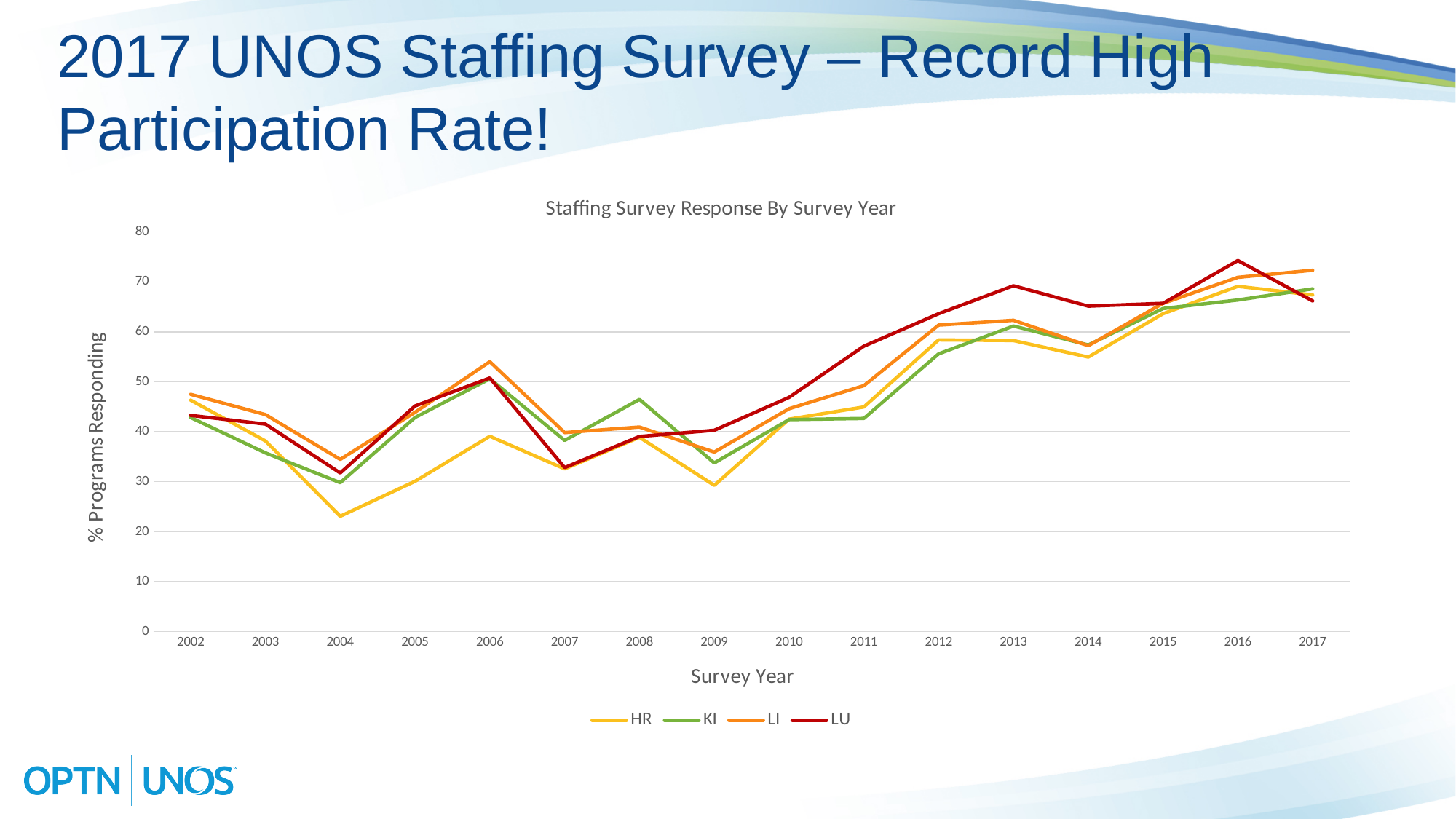
Which is larger for HR: the value in 2002 or the value in 2004? 2002 What is the label of the y axis? % Programs Responding Is the value for LI in 2006 greater or less than 50? greater What kind of chart is shown on the slide? Line chart Is the value for HR in 2004 greater or less than 30? less Is the value for LU in 2016 greater or less than 70? greater How many survey years are plotted along the x axis? 16 Which series has the highest value in 2016? LU What is the title of the chart? Staffing Survey Response By Survey Year Does the HR series rise or fall from 2009 to 2012? Rise How many series does the legend list? 4 In which year does the HR series reach its lowest value? 2004